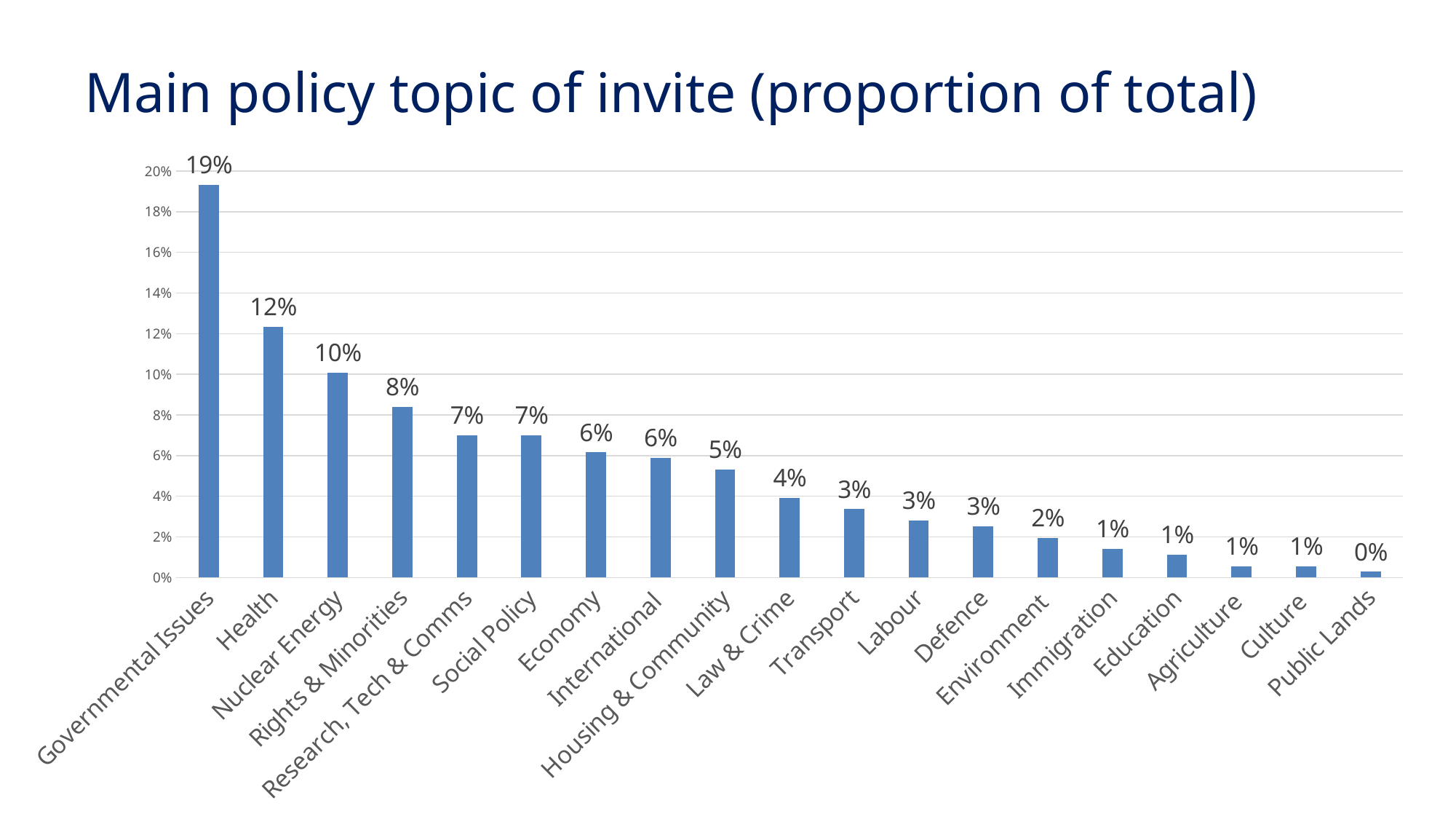
What is the title of the chart? Main policy topic of invite (proportion of total) What is the value for Environment? 2% How many categories are shown on the x axis? 19 What is the value for Law & Crime? 4% What is the value for Health? 12% What is the value for Nuclear Energy? 10% Which category has the highest value? Governmental Issues What kind of chart is shown on the slide? bar chart Which is larger, the value for Rights & Minorities or the value for Economy? Rights & Minorities Is the value for Housing & Community greater or less than 4%? greater What is the difference between the values for Governmental Issues and Health? 7% Which category has the lowest value? Public Lands